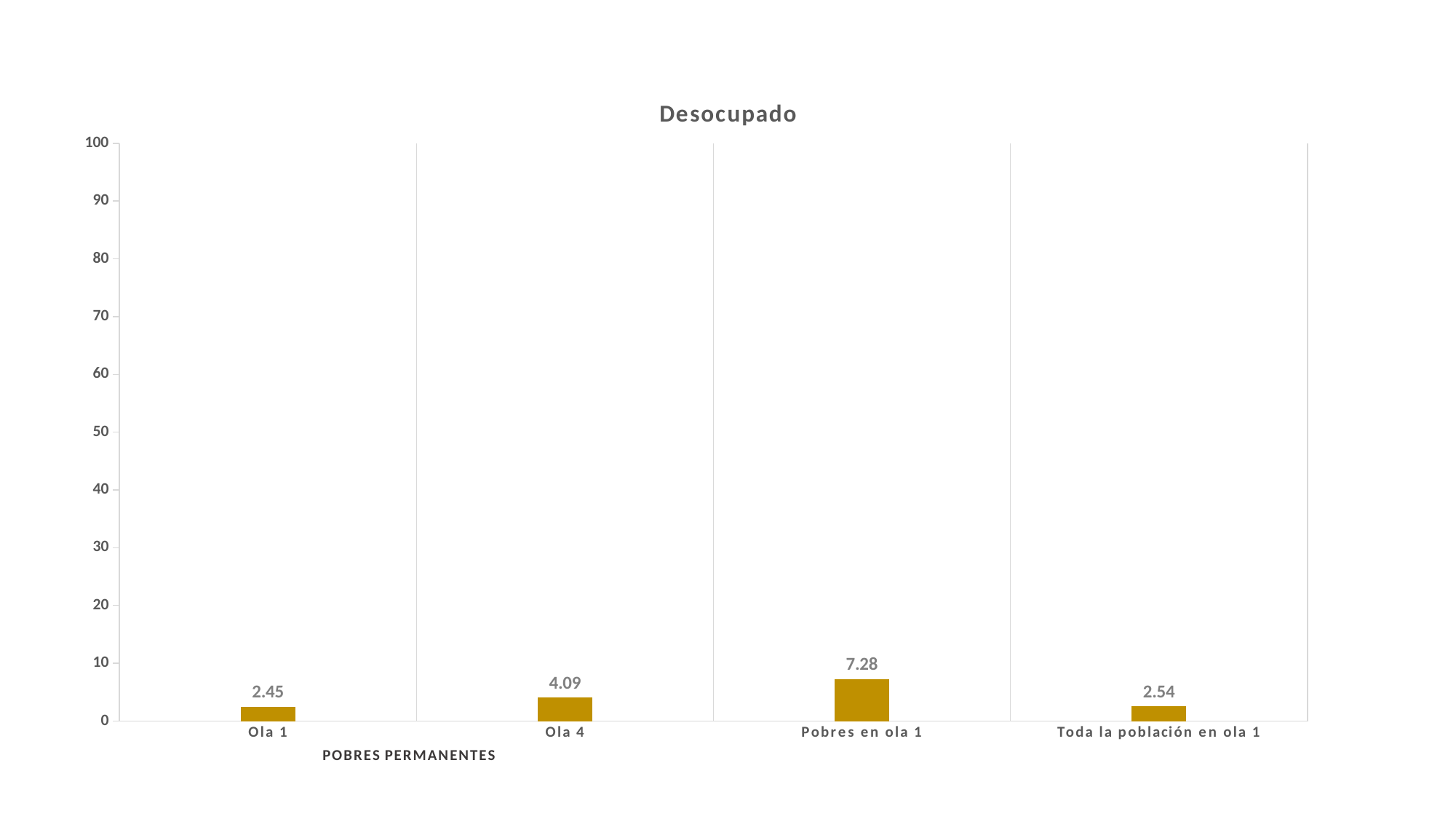
What is the value for Ola 4? 4.09 What is the value for Pobres en ola 1? 7.28 What is the value for Ola 1? 2.45 What is the title of the chart? Desocupado What kind of chart is shown on the slide? bar chart Which is larger, the value for Ola 4 or the value for Toda la población en ola 1? Ola 4 What is the value for Toda la población en ola 1? 2.54 How many categories are shown on the chart? 4 Which category has the lowest value? Ola 1 Which category has the highest value? Pobres en ola 1 Is the value for Pobres en ola 1 greater or less than 10? less What is the difference between the values for Pobres en ola 1 and Ola 4? 3.19